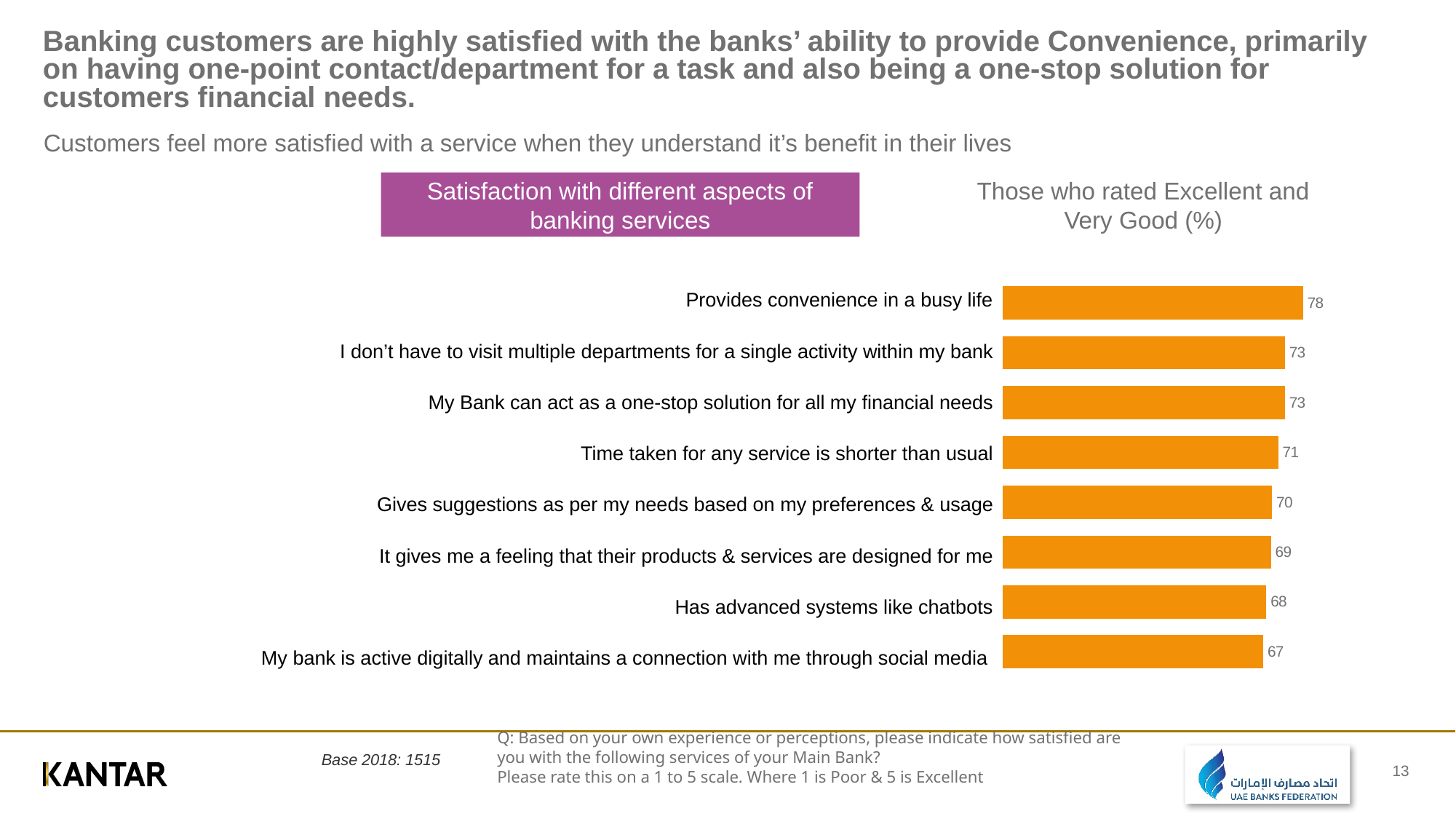
Which aspect of banking services has the lowest percentage of Excellent and Very Good ratings? My bank is active digitally and maintains a connection with me through social media Which aspect of banking services has the highest percentage of Excellent and Very Good ratings? Provides convenience in a busy life Which has a larger value: 'Gives suggestions as per my needs based on my preferences & usage' or 'Has advanced systems like chatbots'? Gives suggestions as per my needs based on my preferences & usage How many aspects of banking services are shown in the chart? 8 What is the difference between the values for 'Provides convenience in a busy life' and 'My bank is active digitally and maintains a connection with me through social media'? 11 What percentage rated 'Provides convenience in a busy life' as Excellent or Very Good? 78 What is the value for 'Time taken for any service is shorter than usual'? 71 What kind of chart is shown on the slide? Bar chart What is the value for 'Has advanced systems like chatbots'? 68 What is the value for 'My Bank can act as a one-stop solution for all my financial needs'? 73 What is the title shown in the purple box above the chart? Satisfaction with different aspects of banking services What is the difference between the values for 'I don't have to visit multiple departments for a single activity within my bank' and 'It gives me a feeling that their products & services are designed for me'? 4